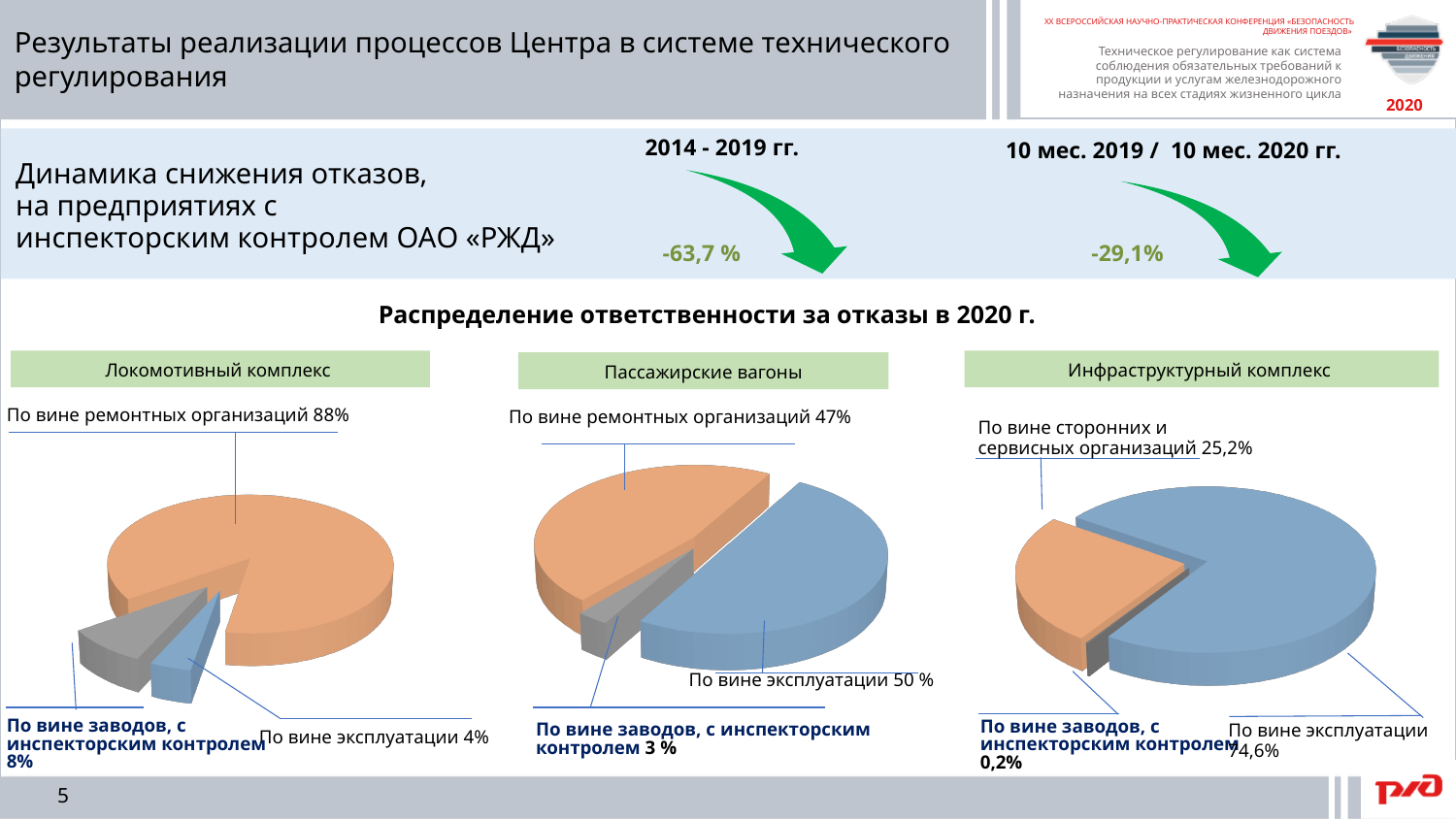
In the 'Пассажирские вагоны' pie chart, what share is attributed to 'По вине эксплуатации'? 50 % In the 'Локомотивный комплекс' pie chart, what share is attributed to 'По вине ремонтных организаций'? 88% In the 'Пассажирские вагоны' pie chart, what share is attributed to 'По вине заводов, с инспекторским контролем'? 3 % In the 'Локомотивный комплекс' pie chart, which category has the largest share? По вине ремонтных организаций In the 'Пассажирские вагоны' pie chart, which category has the smallest share? По вине заводов, с инспекторским контролем In the 'Инфраструктурный комплекс' pie chart, what share is attributed to 'По вине эксплуатации'? 74,6% In the 'Пассажирские вагоны' pie chart, what is the difference between the shares for 'По вине эксплуатации' and 'По вине ремонтных организаций'? 3 % What type of chart is used for 'Инфраструктурный комплекс'? Pie chart In the 'Локомотивный комплекс' pie chart, what share is attributed to 'По вине эксплуатации'? 4% How many slices does the 'Локомотивный комплекс' pie chart have? 3 In the 'Инфраструктурный комплекс' pie chart, which is larger: the share for 'По вине эксплуатации' or for 'По вине сторонних и сервисных организаций'? По вине эксплуатации In the 'Инфраструктурный комплекс' pie chart, what share is attributed to 'По вине сторонних и сервисных организаций'? 25,2%